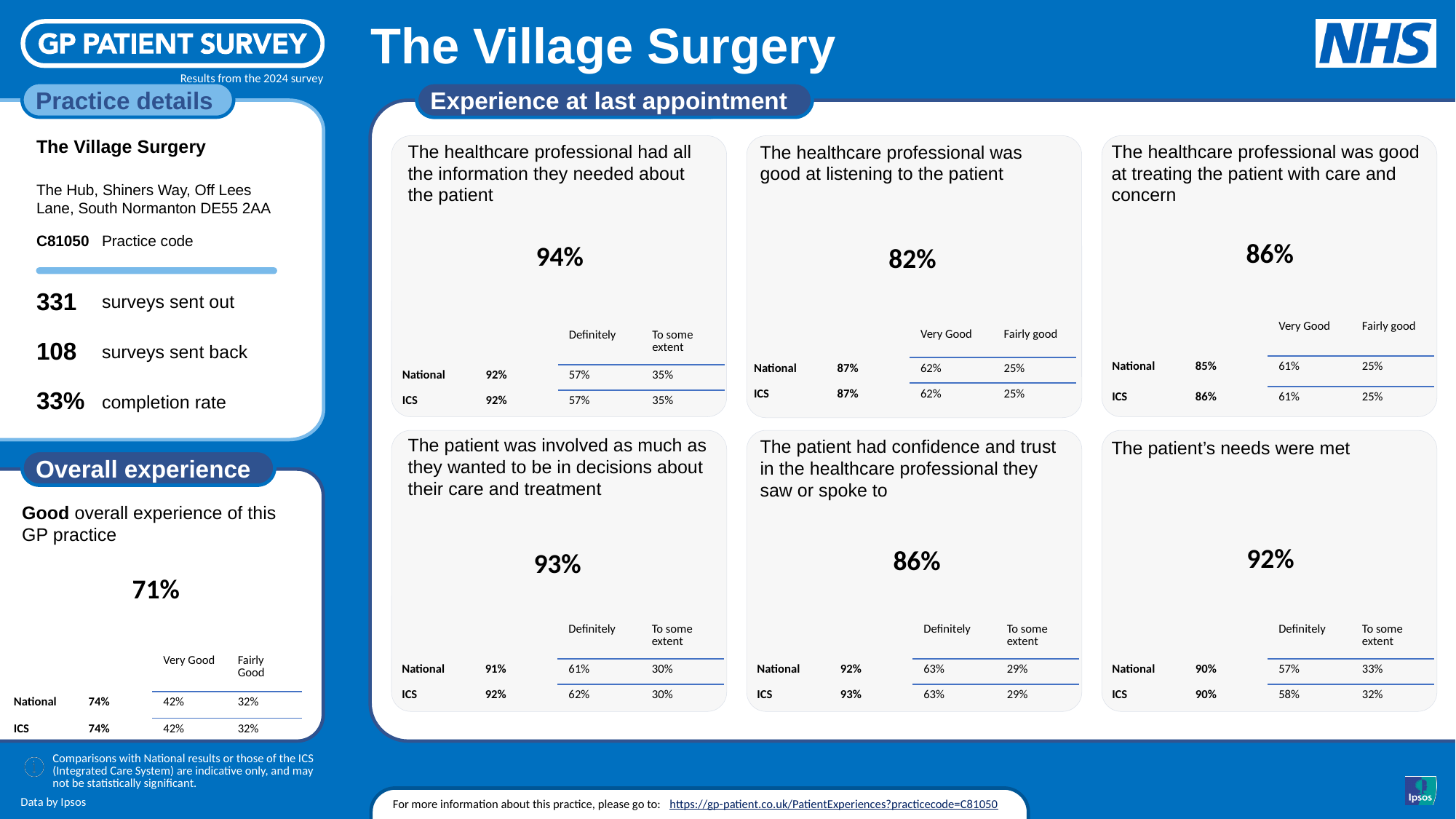
How many question panels are shown under the 'Experience at last appointment' heading? 6 In the 'Overall experience' panel, what is the National figure for good overall experience? 74% In the panel 'The patient was involved as much as they wanted to be in decisions about their care and treatment', what is the ICS figure? 92% In the 'Overall experience' panel, what percentage of patients reported a good overall experience of this GP practice? 71% In the panel 'The patient had confidence and trust in the healthcare professional they saw or spoke to', what is the difference between the ICS figure (93%) and the practice figure (86%)? 7% In the 'Overall experience' panel, what is the difference between the National figure (74%) and the practice figure (71%)? 3% In the panel 'The patient's needs were met', which is larger: the practice figure or the National figure? the practice figure In the panel 'The healthcare professional was good at listening to the patient', what is the practice's percentage? 82% Among the six 'Experience at last appointment' panels, which question has the lowest practice percentage? The healthcare professional was good at listening to the patient In the panel 'The healthcare professional was good at listening to the patient', what is the National 'Very Good' percentage? 62% Among the six 'Experience at last appointment' panels, which question has the highest practice percentage? The healthcare professional had all the information they needed about the patient In the panel 'The healthcare professional had all the information they needed about the patient', what is the practice's percentage? 94%